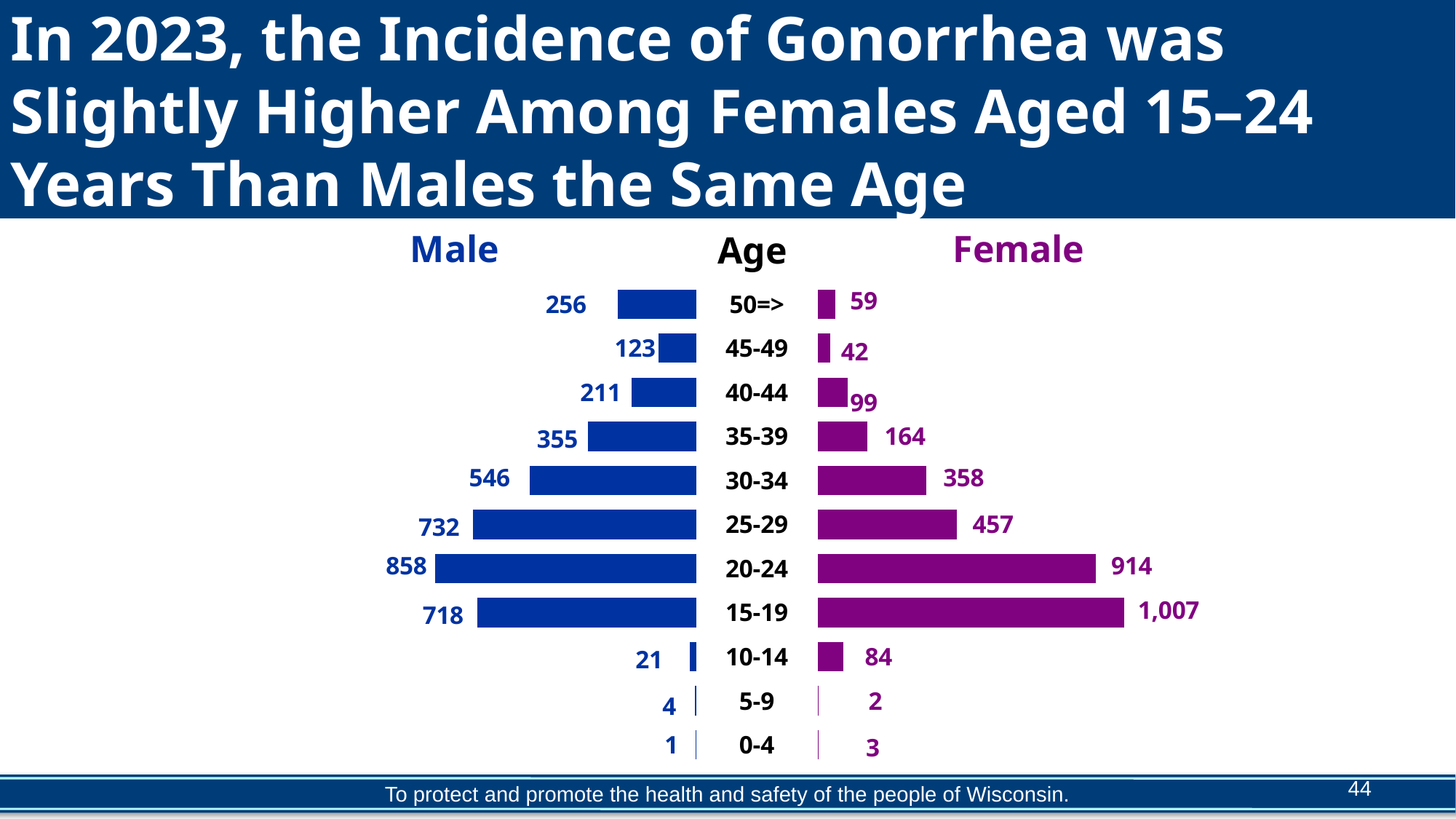
What colour are the female bars? Purple Which age group has the lowest male value? 0-4 Which age group has the highest male value? 20-24 Which is larger for the 25-29 age group, the male value or the female value? Male How many age groups are shown in the chart? 11 What is the male value for the 20-24 age group? 858 What is the male value for the 45-49 age group? 123 What is the female value for the 15-19 age group? 1,007 What is the female value for the 30-34 age group? 358 What is the difference between the female and male values for the 15-19 age group? 289 What type of chart is shown on the slide? Bar chart Which age group has the highest female value? 15-19